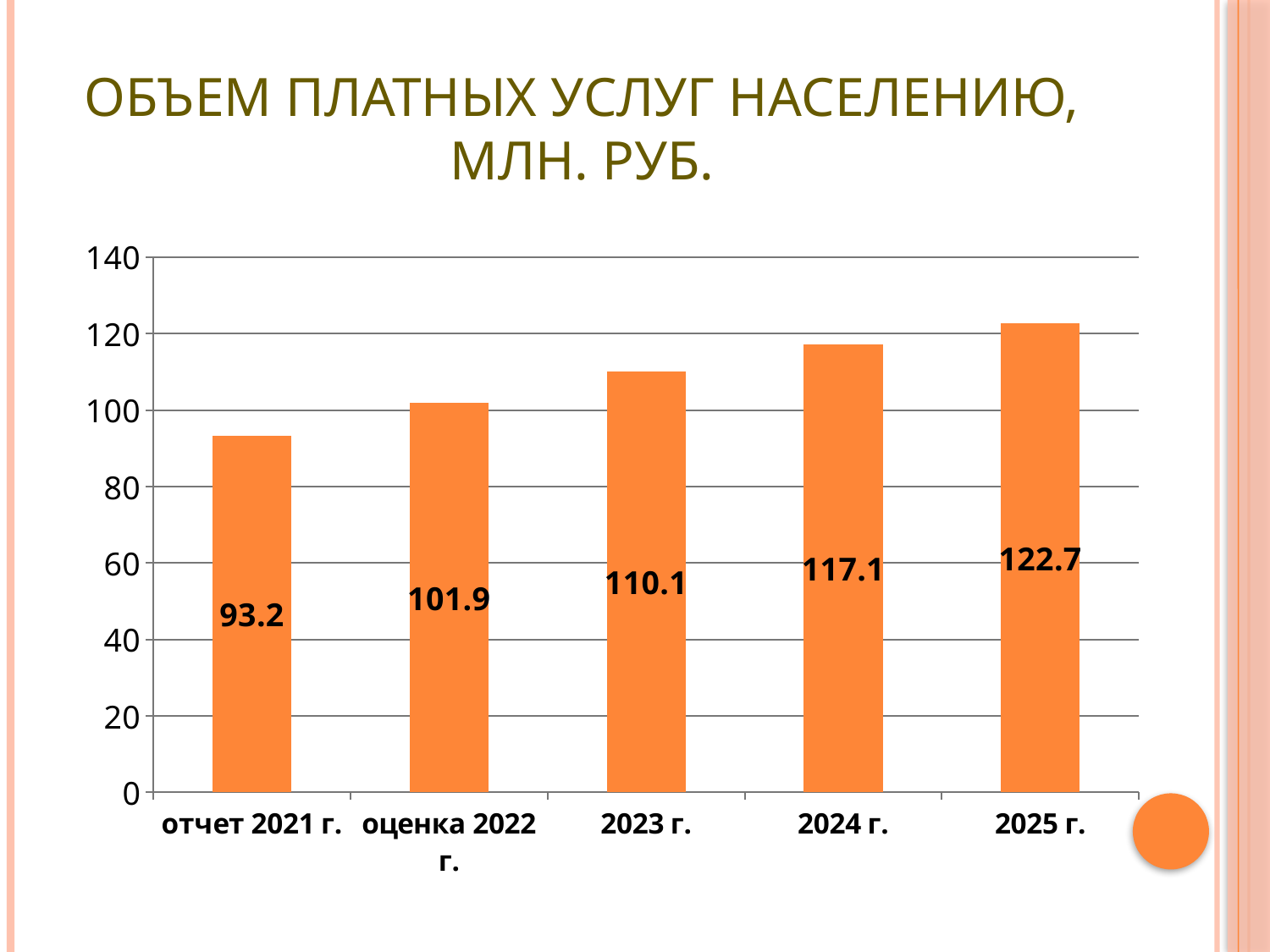
Which category has the highest value? 2025 г. What is the difference between the values for 2023 г. and оценка 2022 г.? 8.2 What is the value for отчет 2021 г.? 93.2 How many categories are shown on the x axis? 5 Which category has the lowest value? отчет 2021 г. What is the value for оценка 2022 г.? 101.9 What kind of chart is shown on the slide? bar chart What is the value for 2024 г.? 117.1 Is the value for 2025 г. greater or less than 120? greater What is the difference between the values for 2025 г. and отчет 2021 г.? 29.5 Do the values rise or fall from left to right along the x axis? rise Which is larger, the value for 2023 г. or the value for 2024 г.? 2024 г.